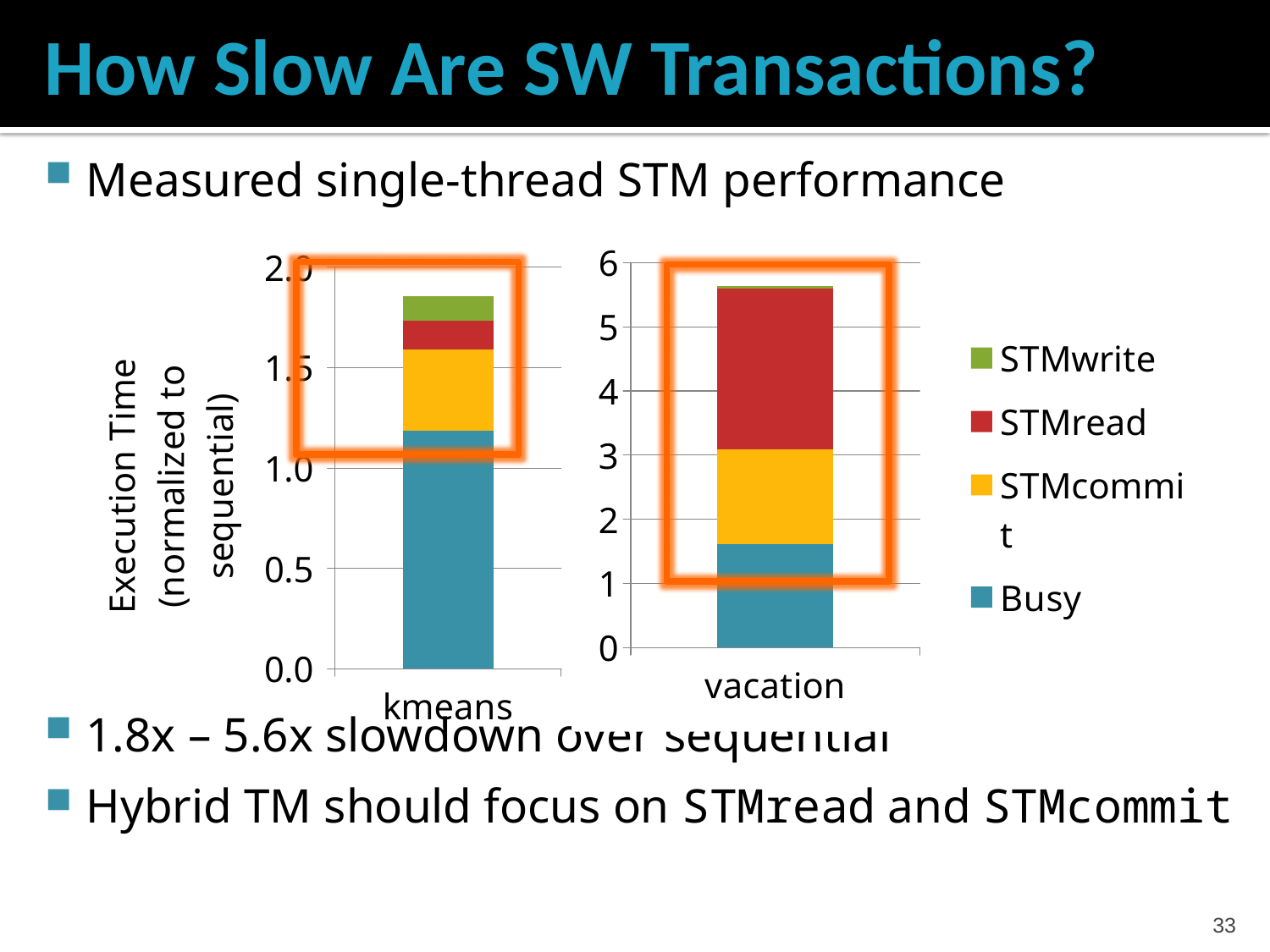
What kind of chart is used on the slide to show execution time for kmeans and vacation? stacked bar chart How many series does the legend list? 4 Which benchmark has the larger total normalized execution time, kmeans or vacation? vacation In the vacation chart, which series has the largest segment? STMread In the vacation chart, is the total height of the stacked bar greater or less than 5? greater In the kmeans chart, does the Busy segment reach above or below 1.0? above In the vacation chart, which series has the smallest segment? STMwrite In the kmeans chart, is the total height of the stacked bar greater or less than 1.5? greater In the kmeans chart, which series has the largest segment? Busy What colour represents STMread in the legend? red What is the y-axis title of the left chart? Execution Time (normalized to sequential)